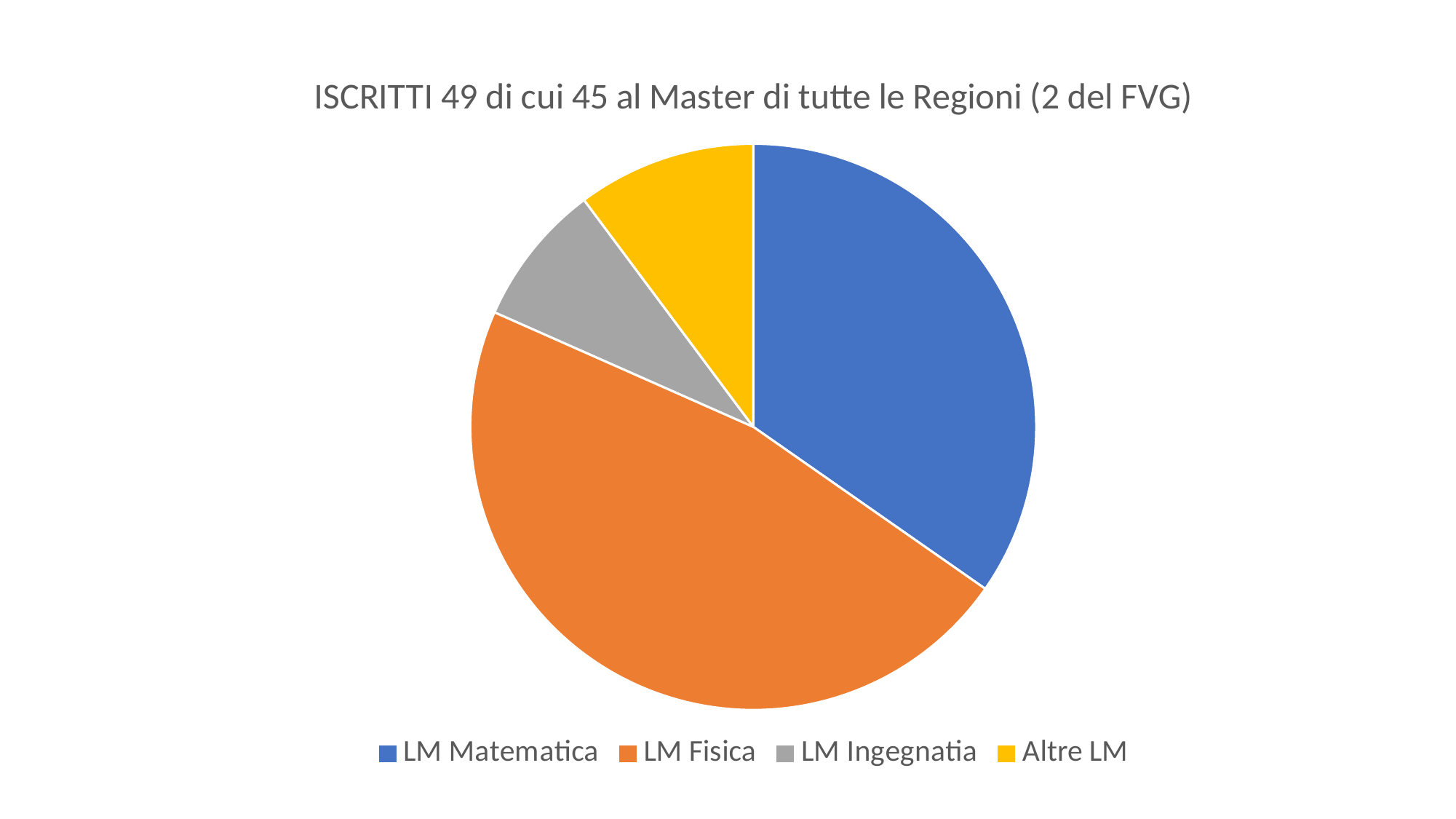
How many slices does the pie chart have? 4 Which category has the largest slice of the pie? LM Fisica What kind of chart is shown on the slide? pie chart Which slice is larger, LM Matematica or LM Ingegnatia? LM Matematica What is the title of the chart? ISCRITTI 49 di cui 45 al Master di tutte le Regioni (2 del FVG) Which slice is larger, LM Fisica or LM Matematica? LM Fisica Which slice is larger, LM Fisica or LM Ingegnatia? LM Fisica Which category is shown in orange in the pie chart? LM Fisica